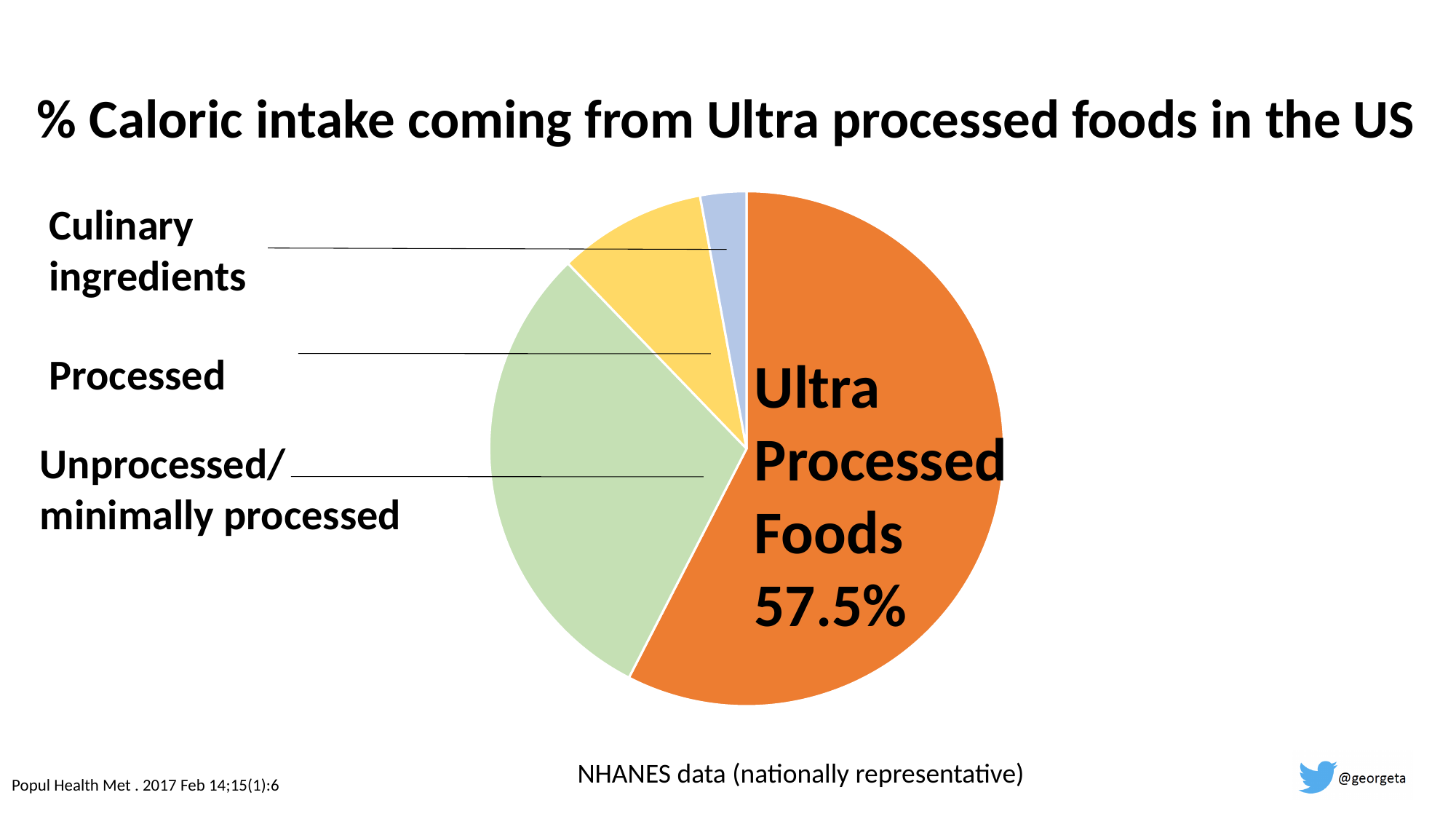
Which category accounts for the largest share of caloric intake? Ultra Processed Foods What percentage of caloric intake comes from Ultra Processed Foods? 57.5% What colour is the Ultra Processed Foods slice? Orange How many slices does the pie chart have? 4 Which has a larger share: Ultra Processed Foods or Unprocessed/minimally processed? Ultra Processed Foods What is the title of the chart? % Caloric intake coming from Ultra processed foods in the US Which has a larger share: Unprocessed/minimally processed or Processed? Unprocessed/minimally processed What kind of chart is shown on the slide? Pie chart Which category is the second largest slice of the pie? Unprocessed/minimally processed Which category accounts for the smallest share of caloric intake? Culinary ingredients